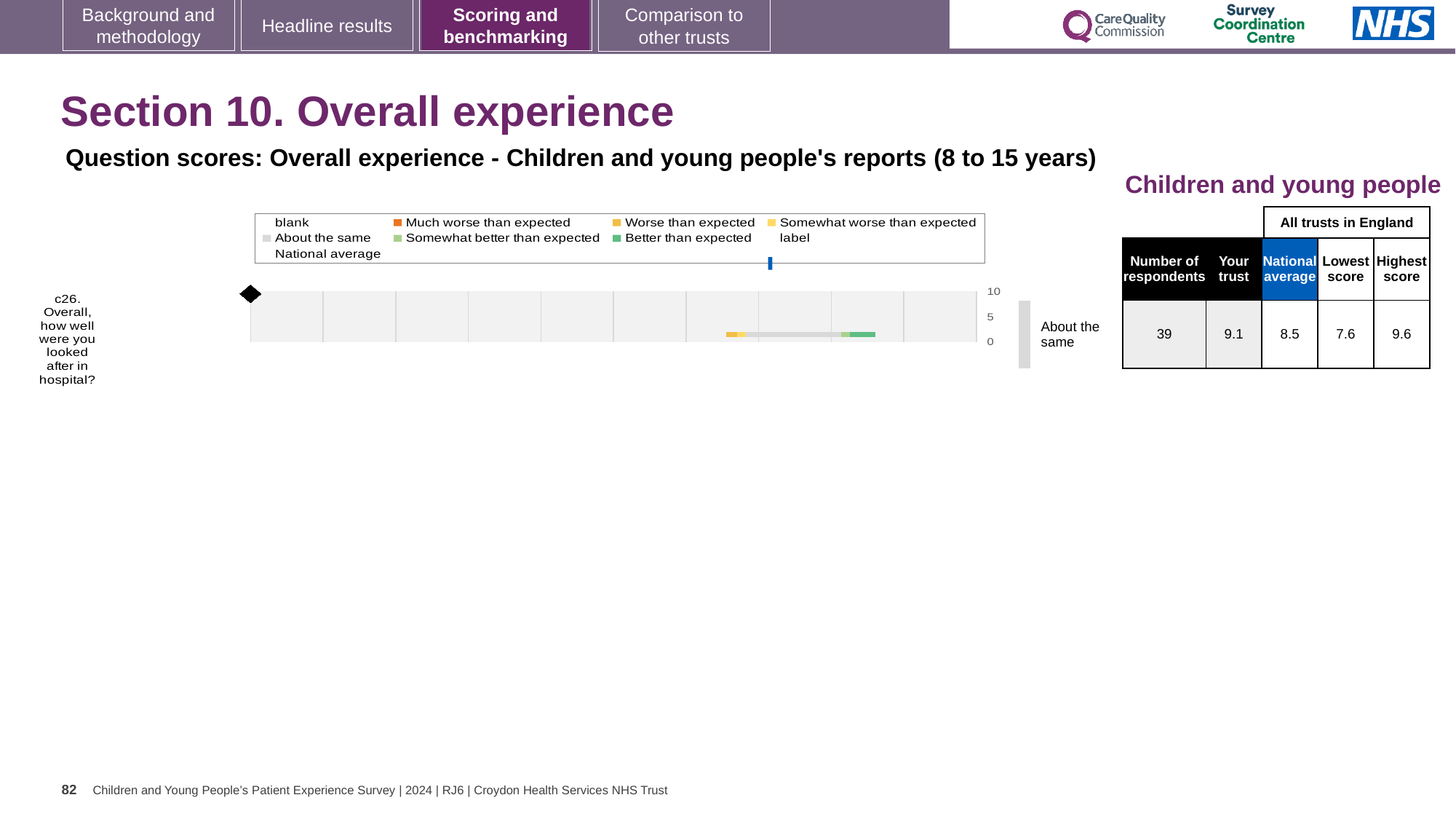
According to the table beside the chart, what is the national average score for c26? 8.5 According to the table beside the chart, what is the lowest score among all trusts in England for c26? 7.6 What is the highest value shown on the chart's axis? 10 Which is larger for c26: the 'Your trust' score or the national average? Your trust What kind of chart is used to show the question score for c26? bar chart What is the difference between the highest score and the lowest score for c26 in the table beside the chart? 2 Which question is plotted in the chart? c26. Overall, how well were you looked after in hospital? According to the table beside the chart, what is the 'Your trust' score for c26? 9.1 How many survey questions are plotted in the chart? 1 What benchmark category is shown to the right of the bar for c26? About the same How many respondents answered question c26, according to the table beside the chart? 39 According to the table beside the chart, what is the highest score among all trusts in England for c26? 9.6